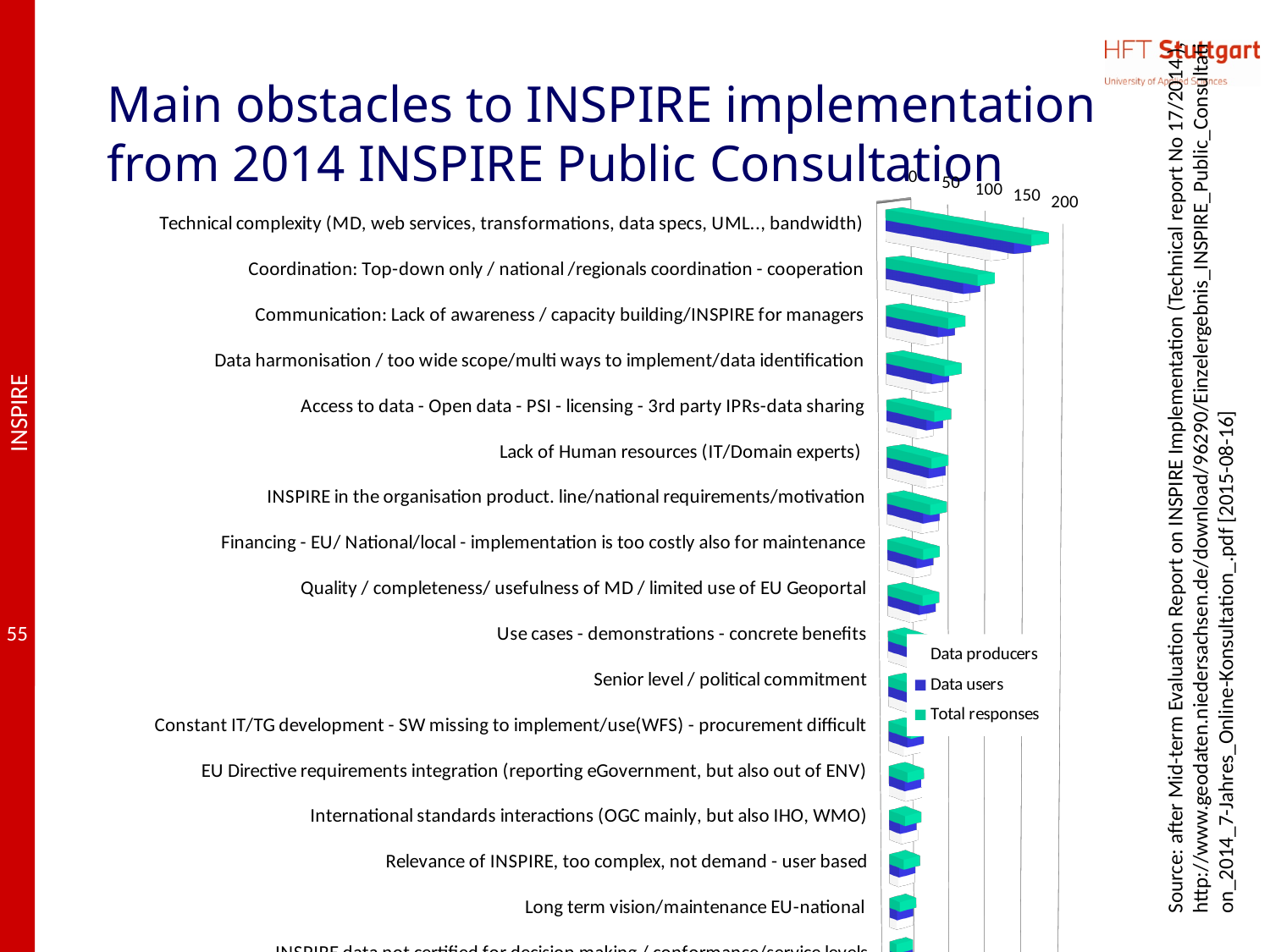
What kind of chart is shown on the slide? bar chart Is the Total responses value for Senior level / political commitment greater or less than 100? less Is the Total responses value for Technical complexity greater or less than 100? greater What is the highest value shown on the chart's value axis? 200 Do the bar lengths increase or decrease going down the list of categories from top to bottom? decrease Is the Total responses value for Long term vision/maintenance EU-national greater or less than 50? less Which has more total responses: Technical complexity or Coordination: Top-down only / national /regionals coordination - cooperation? Technical complexity Which has more total responses: Lack of Human resources (IT/Domain experts) or Use cases - demonstrations - concrete benefits? Lack of Human resources (IT/Domain experts) How many series does the chart legend list? 3 Which obstacle category has the highest number of responses? Technical complexity (MD, web services, transformations, data specs, UML.., bandwidth) Which series are listed in the chart legend? Data producers, Data users, Total responses